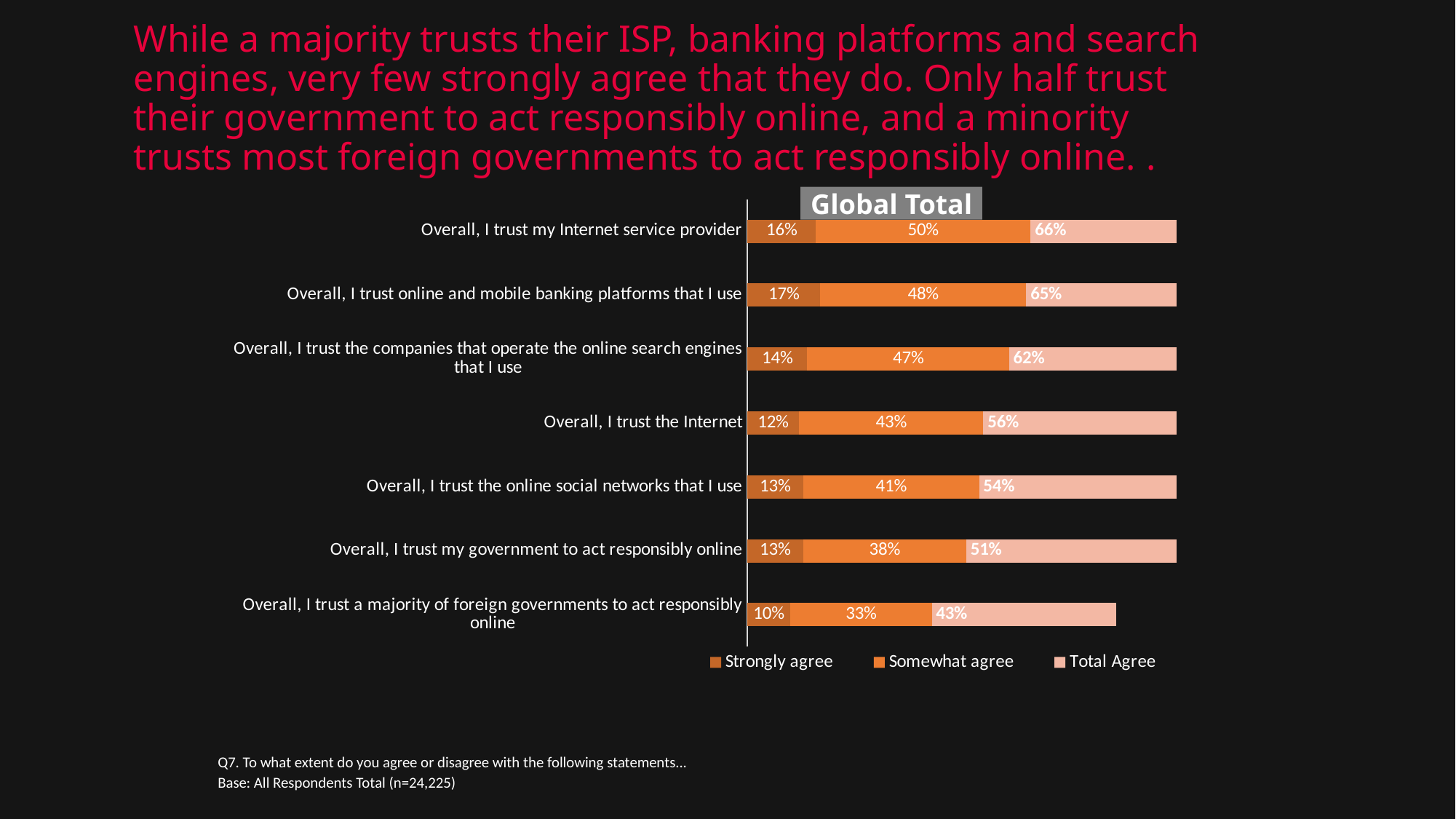
What is the Total Agree value for "Overall, I trust the Internet"? 56% What is the difference in Total Agree between "Overall, I trust my Internet service provider" and "Overall, I trust a majority of foreign governments to act responsibly online"? 23% How many series does the legend list? 3 What is the title shown above the chart? Global Total Which has a larger Somewhat agree value: "Overall, I trust the Internet" or "Overall, I trust the online social networks that I use"? Overall, I trust the Internet Which statement has the highest Total Agree value? Overall, I trust my Internet service provider What is the Strongly agree value for "Overall, I trust online and mobile banking platforms that I use"? 17% What is the Somewhat agree value for "Overall, I trust my government to act responsibly online"? 38% What kind of chart is shown on the slide? Stacked bar chart How many statements are shown in the chart? 7 What is the Strongly agree value for "Overall, I trust my Internet service provider"? 16% Which statement has the lowest Strongly agree value? Overall, I trust a majority of foreign governments to act responsibly online